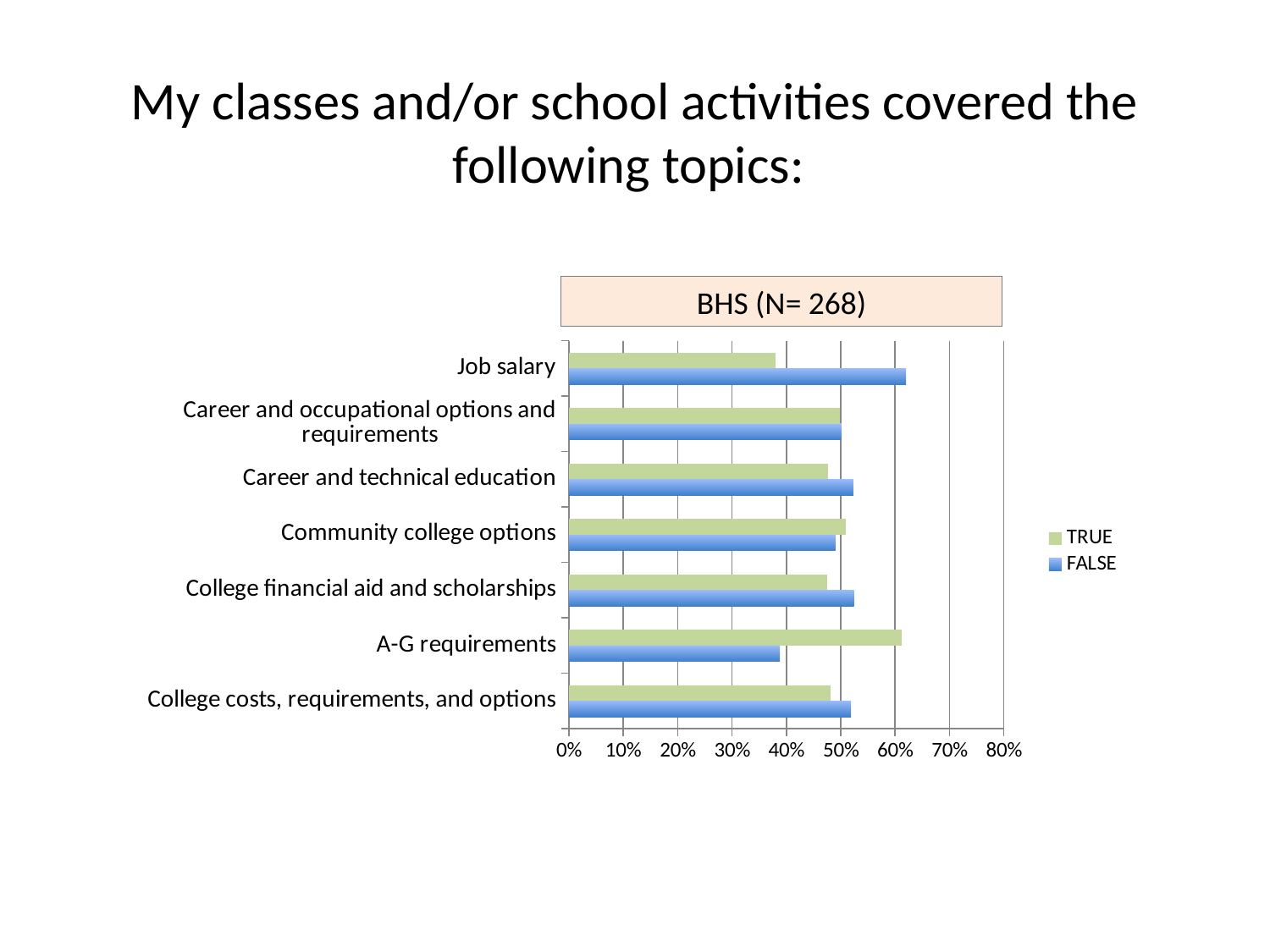
How many topics (categories) are listed on the chart? 7 Which topic has the lowest TRUE value? Job salary Is the TRUE value for Job salary greater or less than 40%? less For Job salary, which is larger, the TRUE value or the FALSE value? FALSE Which topic has the highest TRUE value? A-G requirements What kind of chart is shown on the slide? bar chart Which topic has the lowest FALSE value? A-G requirements Which topic has the highest FALSE value? Job salary What is the title shown above the chart? BHS (N= 268) Is the FALSE value for Job salary greater or less than 50%? greater How many series does the chart's legend list? 2 For A-G requirements, which is larger, the TRUE value or the FALSE value? TRUE